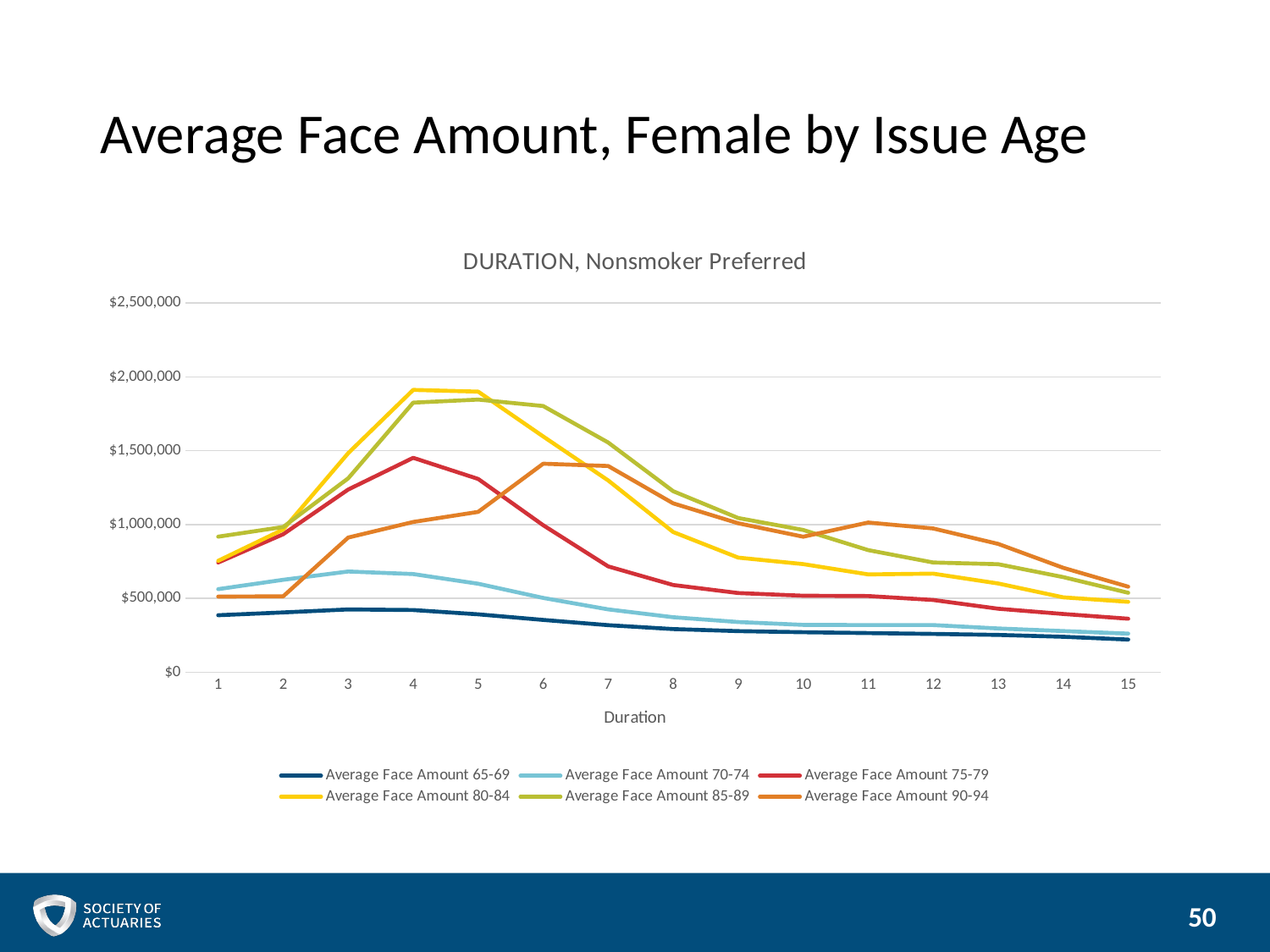
Is the value for Average Face Amount 85-89 at duration 1 greater or less than $1,000,000? less Is the value for Average Face Amount 65-69 at duration 1 greater or less than $500,000? less Is the value for Average Face Amount 90-94 at duration 6 greater or less than $1,000,000? greater What kind of chart is shown on the slide? line chart How many durations are plotted along the x axis? 15 Which series has the lowest value at duration 15? Average Face Amount 65-69 How many series does the legend list? 6 At duration 10, which is larger: Average Face Amount 90-94 or Average Face Amount 65-69? Average Face Amount 90-94 Does the Average Face Amount 65-69 series rise or fall from duration 4 to duration 15? fall What is the title shown above the chart? DURATION, Nonsmoker Preferred At duration 4, which is larger: Average Face Amount 80-84 or Average Face Amount 75-79? Average Face Amount 80-84